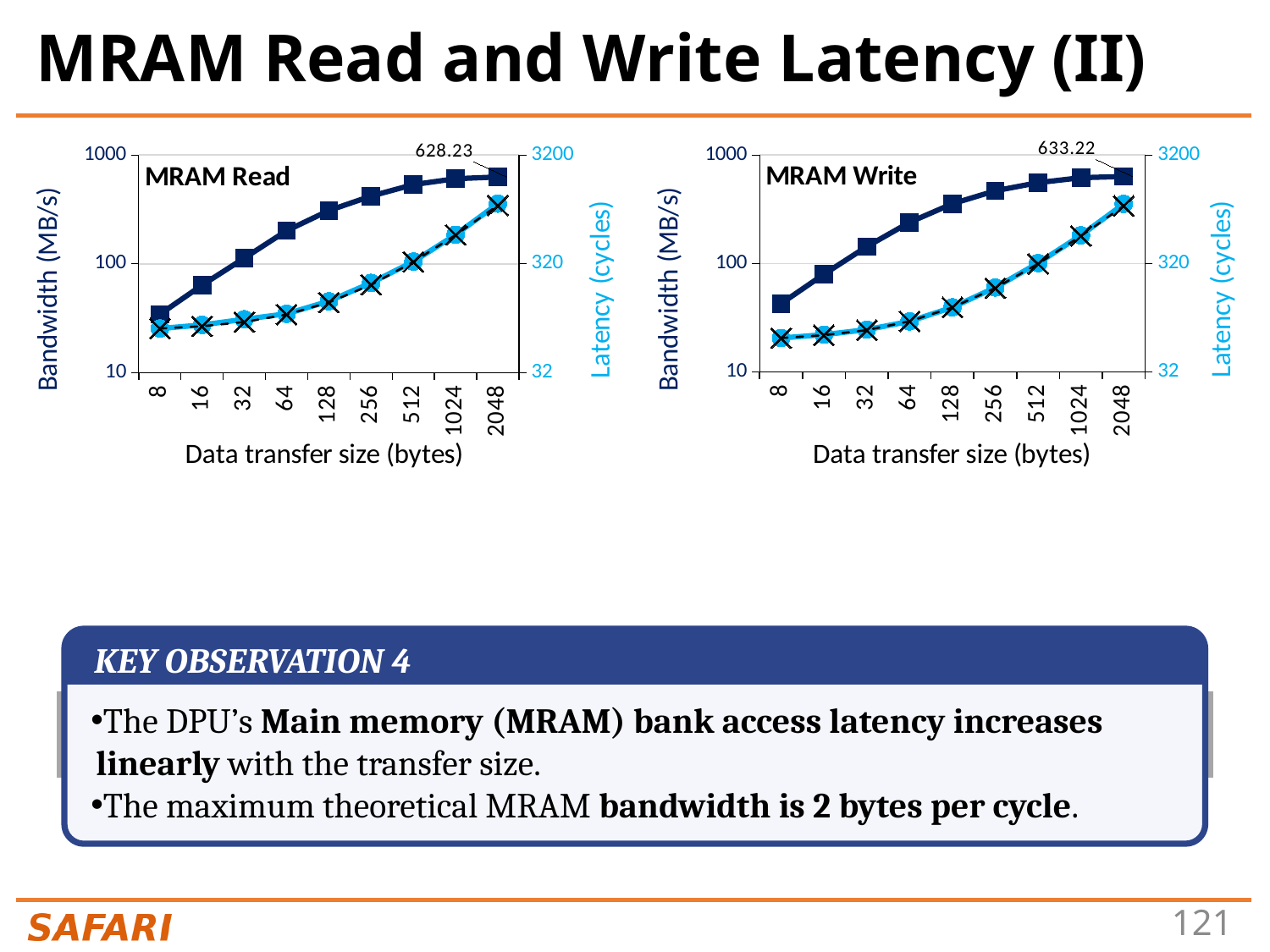
What is the difference between the labelled bandwidth at 2048 bytes in the MRAM Write chart and in the MRAM Read chart? 4.99 In the MRAM Read chart, at which data transfer size is the bandwidth highest? 2048 In the MRAM Read chart, how many data transfer sizes are plotted on the x axis? 9 What is the label of the left vertical axis in the MRAM Read chart? Bandwidth (MB/s) In the MRAM Read chart, what is the bandwidth value labelled at a data transfer size of 2048 bytes? 628.23 In the MRAM Write chart, what is the bandwidth value labelled at a data transfer size of 2048 bytes? 633.22 In the MRAM Write chart, is the latency at a data transfer size of 8 bytes greater or less than 320 cycles? less What kind of chart is the MRAM Write chart? Line chart In the MRAM Write chart, does latency rise or fall as the data transfer size increases? Rises Which chart shows the higher labelled bandwidth at 2048 bytes, MRAM Read or MRAM Write? MRAM Write In the MRAM Read chart, does bandwidth rise or fall as the data transfer size increases? Rises In the MRAM Read chart, is the bandwidth at a data transfer size of 8 bytes greater or less than 100 MB/s? less